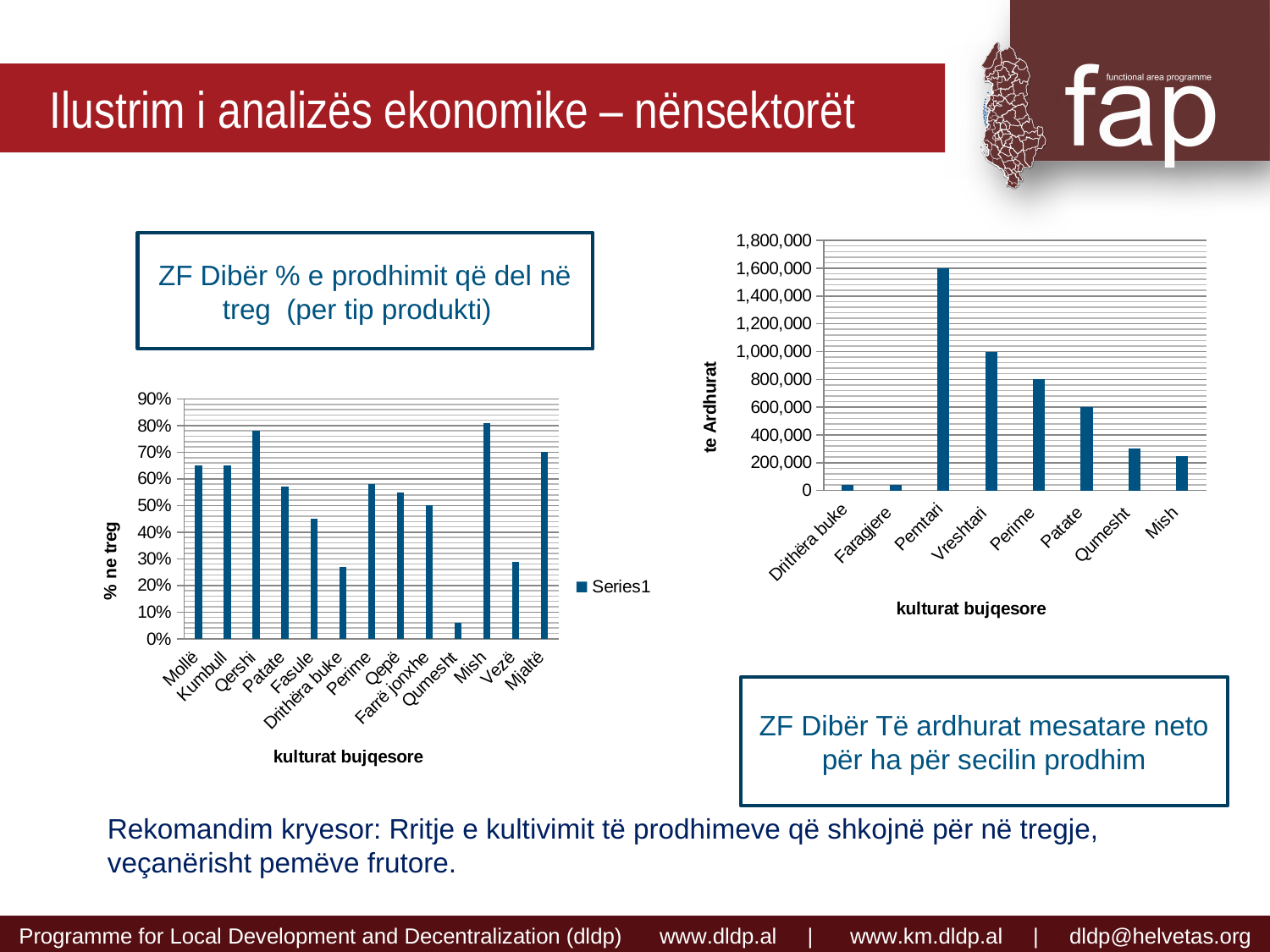
On the left chart (ZF Dibër % e prodhimit që del në treg), how many series does the legend list? 1 On the left chart (ZF Dibër % e prodhimit që del në treg), how many product categories are shown on the x axis? 13 On the left chart (ZF Dibër % e prodhimit që del në treg), is the value for Qershi greater or less than 70%? greater On the right chart (ZF Dibër Të ardhurat mesatare neto për ha), which category has the highest value? Pemtari On the left chart (ZF Dibër % e prodhimit që del në treg), what kind of chart is shown? bar chart On the right chart (ZF Dibër Të ardhurat mesatare neto për ha), what is the difference between the values for Pemtari and Patate? 1,000,000 On the left chart (ZF Dibër % e prodhimit që del në treg), which category has the lowest value? Qumesht On the right chart (ZF Dibër Të ardhurat mesatare neto për ha), what is the value for Vreshtari? 1,000,000 On the right chart (ZF Dibër Të ardhurat mesatare neto për ha), what is the value for Pemtari? 1,600,000 On the left chart (ZF Dibër % e prodhimit që del në treg), is the value for Drithëra buke greater or less than 30%? less On the right chart (ZF Dibër Të ardhurat mesatare neto për ha), how many categories are shown on the x axis? 8 On the left chart (ZF Dibër % e prodhimit që del në treg), which category has the highest value? Mish